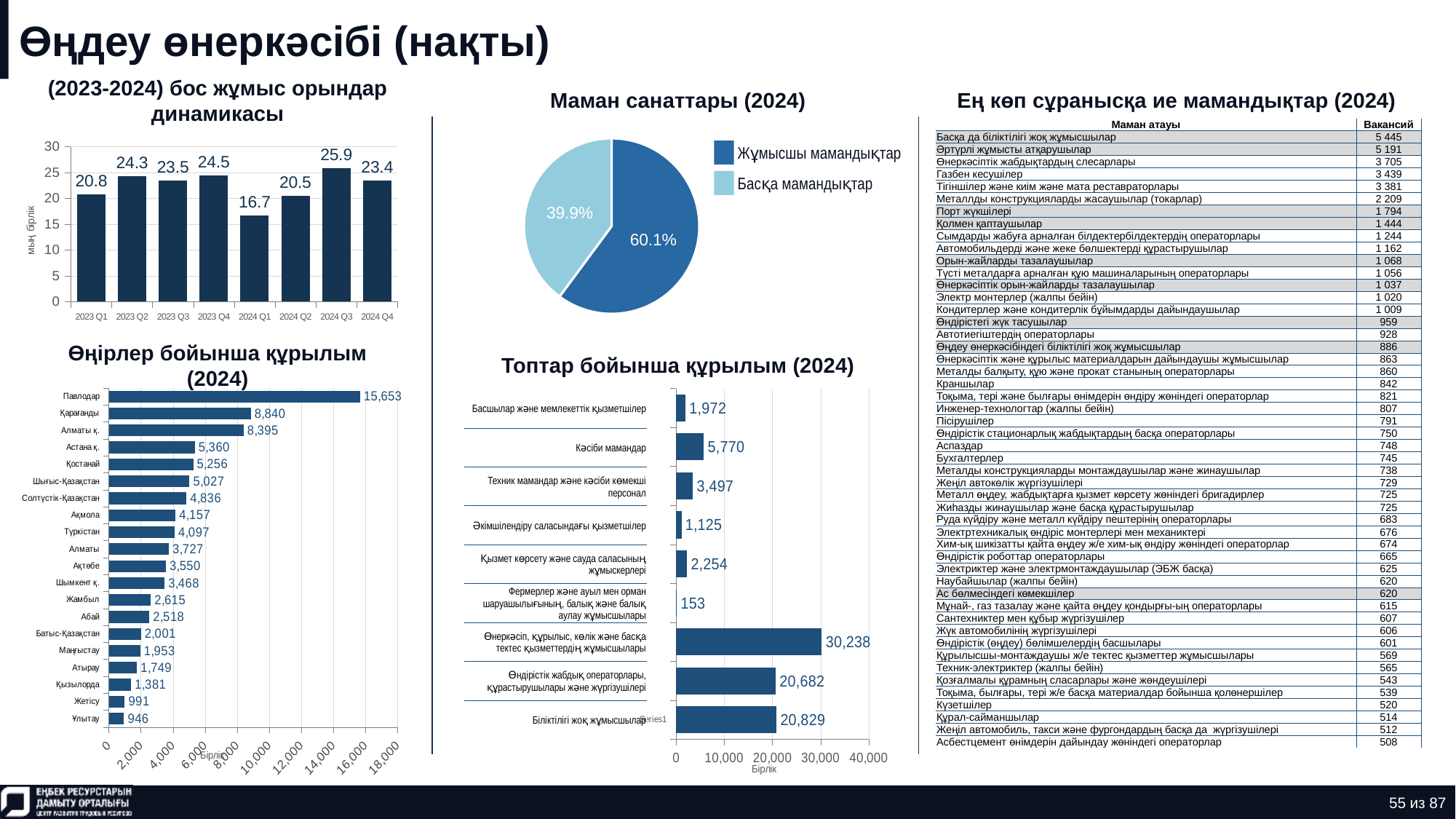
In the chart 'Топтар бойынша құрылым (2024)', which group has the highest value? Өнеркәсіп, құрылыс, көлік және басқа тектес қызметтердің жұмысшылары What kind of chart is 'Маман санаттары (2024)'? Pie chart In the chart 'Топтар бойынша құрылым (2024)', what is the value for 'Фермерлер және ауыл мен орман шаруашылығының, балық және балық аулау жұмысшылары'? 153 In the chart 'Өңірлер бойынша құрылым (2024)', what is the value for Қарағанды? 8,840 In the chart 'Топтар бойынша құрылым (2024)', which is larger: 'Кәсіби мамандар' or 'Басшылар және мемлекеттік қызметшілер'? Кәсіби мамандар In the pie chart 'Маман санаттары (2024)', what share is 'Жұмысшы мамандықтар'? 60.1% In the chart 'Өңірлер бойынша құрылым (2024)', how many regions are shown? 20 In the chart '(2023-2024) бос жұмыс орындар динамикасы', what is the value for 2024 Q1? 16.7 In the chart '(2023-2024) бос жұмыс орындар динамикасы', how many quarters are plotted? 8 In the chart '(2023-2024) бос жұмыс орындар динамикасы', what is the difference between 2024 Q3 and 2024 Q1? 9.2 In the chart '(2023-2024) бос жұмыс орындар динамикасы', which quarter has the highest value? 2024 Q3 In the chart 'Өңірлер бойынша құрылым (2024)', which region has the lowest value? Ұлытау